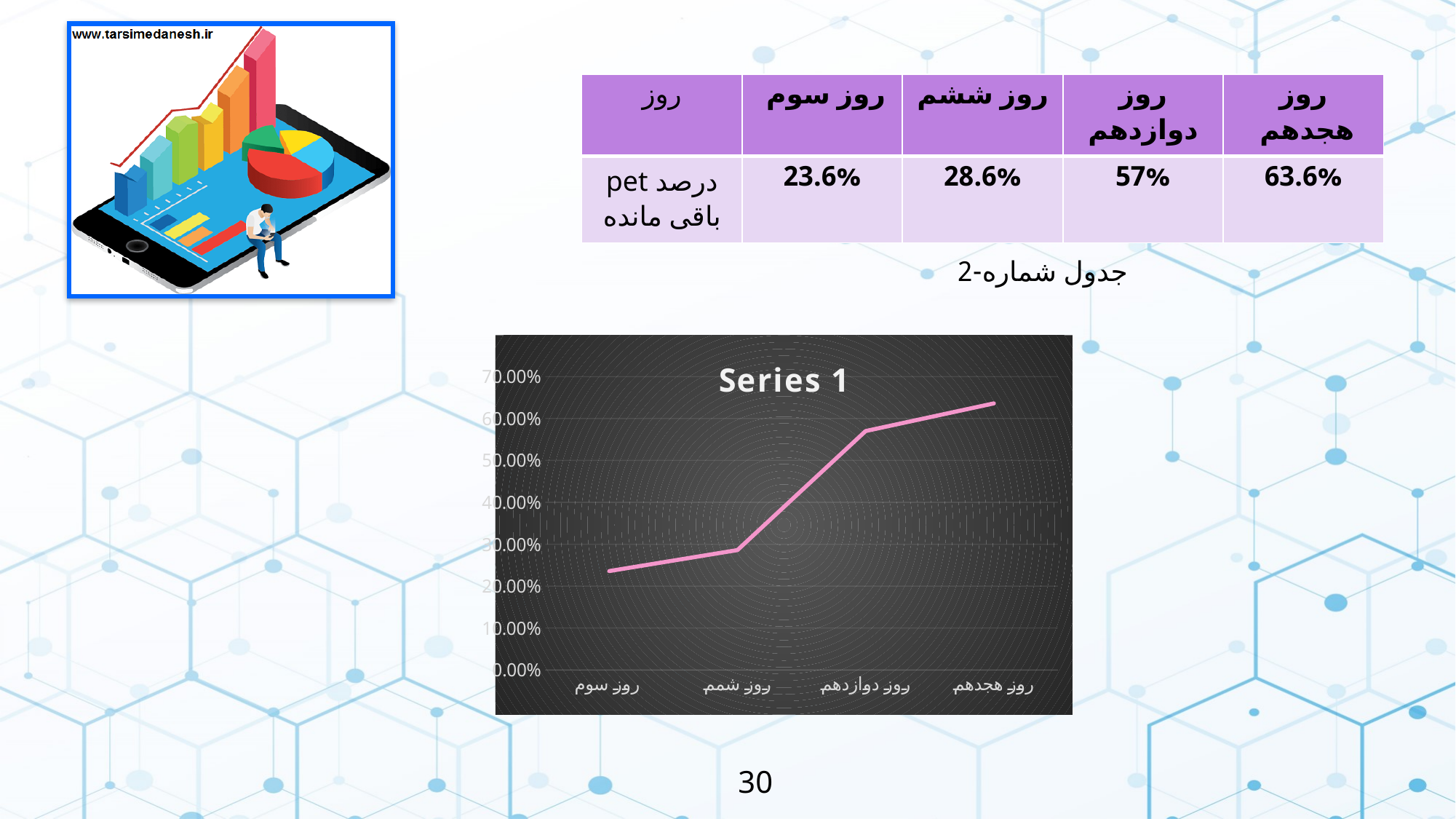
How many data points are plotted on the line chart? 4 Using the values in the table, what is the difference between روز هجدهم and روز سوم? 40% Is the value for روز هجدهم greater or less than 60.00%? greater Do the values rise or fall along the x axis from روز سوم to روز هجدهم? rise What kind of chart is shown on the slide? line chart Is the value for روز سوم greater or less than 30.00%? less Is the value for روز دوازدهم greater or less than 50.00%? greater Which category has the highest value on the chart? روز هجدهم What is the title of the chart? Series 1 According to the table on the slide, what is the value plotted for روز دوازدهم? 57% Which category has the lowest value on the chart? روز سوم Which is larger, the value for روز ششم or the value for روز دوازدهم? روز دوازدهم